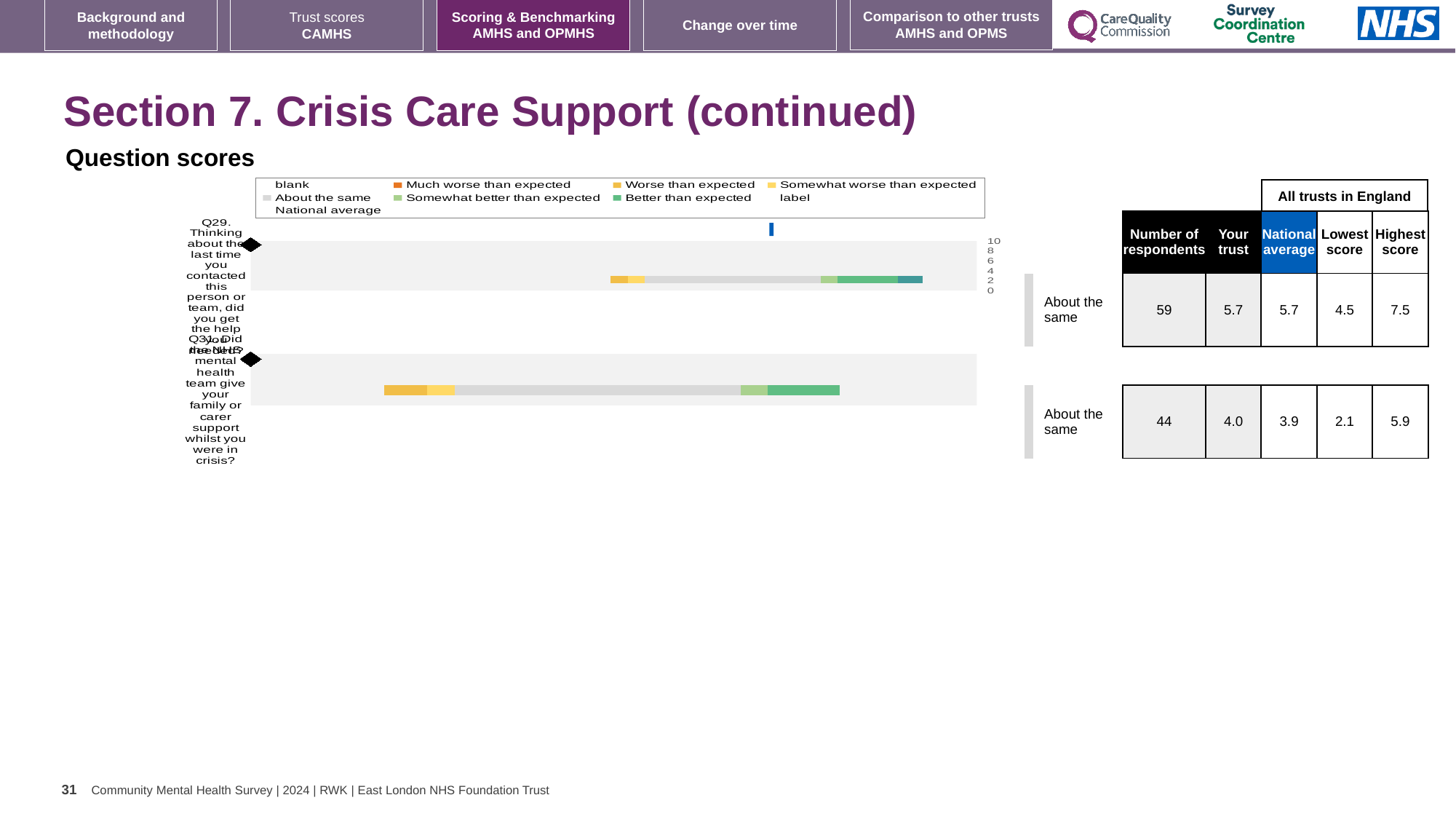
Which legend entry in the Question scores chart is shown in dark orange? Much worse than expected What is the highest value shown on the numeric axis of the Question scores chart? 10 In the table beside the Question scores chart, what is the 'Your trust' score for Q31? 4.0 How many entries does the legend of the Question scores chart list? 9 In the table beside the Question scores chart, which question has the higher 'Your trust' score, Q29 or Q31? Q29 What kind of chart is shown under 'Question scores'? bar chart How many questions (categories) are plotted in the Question scores chart? 2 In the table beside the Question scores chart, what is the difference between the highest score and lowest score for Q29? 3.0 In the table beside the Question scores chart, what is the 'Your trust' score for Q29? 5.7 In the table beside the Question scores chart, what is the number of respondents for Q31? 44 In the Question scores chart, which benchmark category is the trust placed in for Q31? About the same In the Question scores chart, which benchmark category is the trust placed in for Q29? About the same